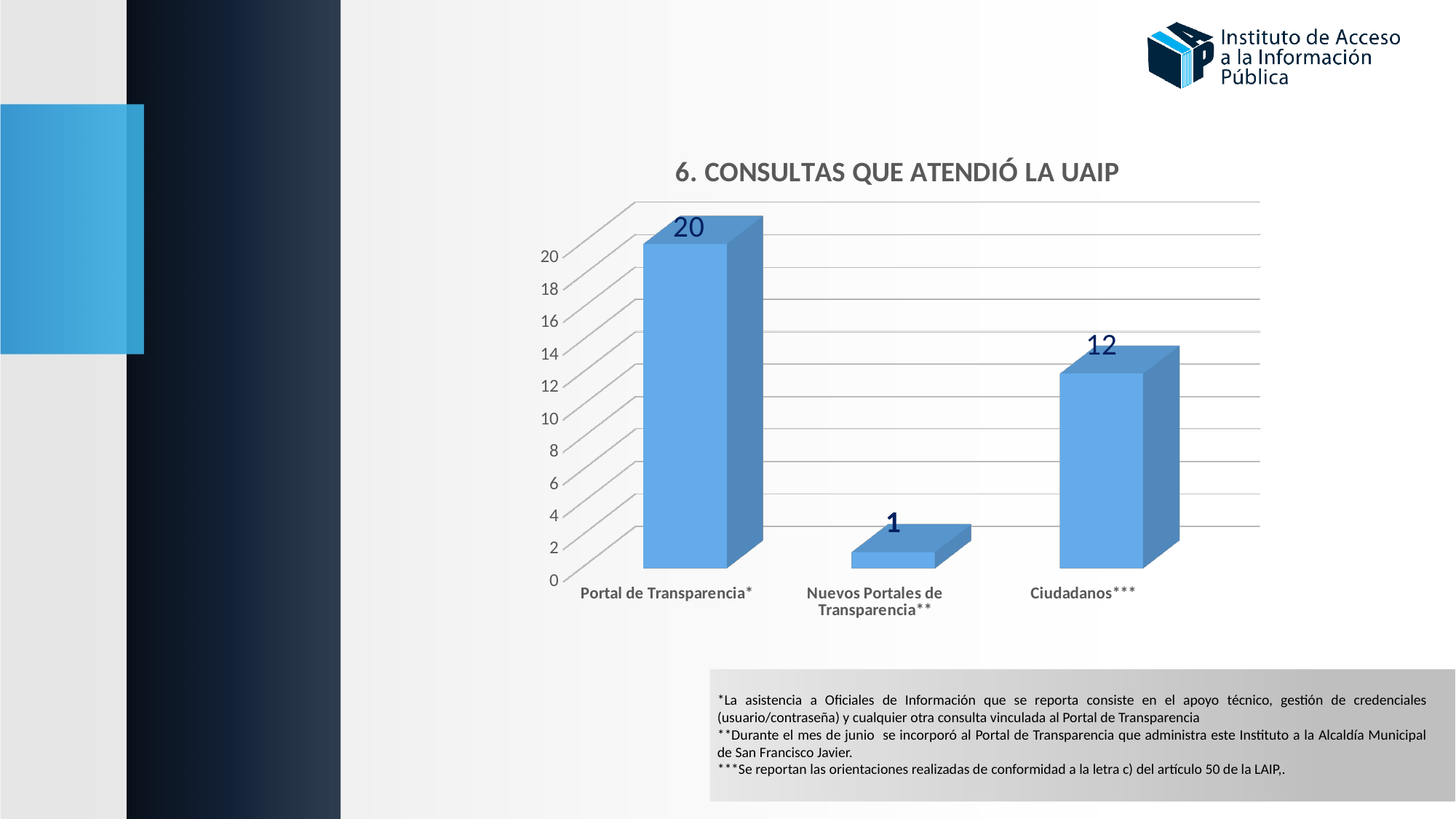
What is the value for Nuevos Portales de Transparencia**? 1 Is the value for Ciudadanos*** greater or less than 10? greater Which category has the highest value? Portal de Transparencia* What is the difference between the values for Ciudadanos*** and Nuevos Portales de Transparencia**? 11 What is the difference between the values for Portal de Transparencia* and Ciudadanos***? 8 What is the value for Ciudadanos***? 12 Which category has the lowest value? Nuevos Portales de Transparencia** How many categories are shown in the chart? 3 What kind of chart is shown on the slide? bar chart What is the value for Portal de Transparencia*? 20 Which is larger, the value for Ciudadanos*** or the value for Nuevos Portales de Transparencia**? Ciudadanos*** What is the title of the chart? 6. CONSULTAS QUE ATENDIÓ LA UAIP